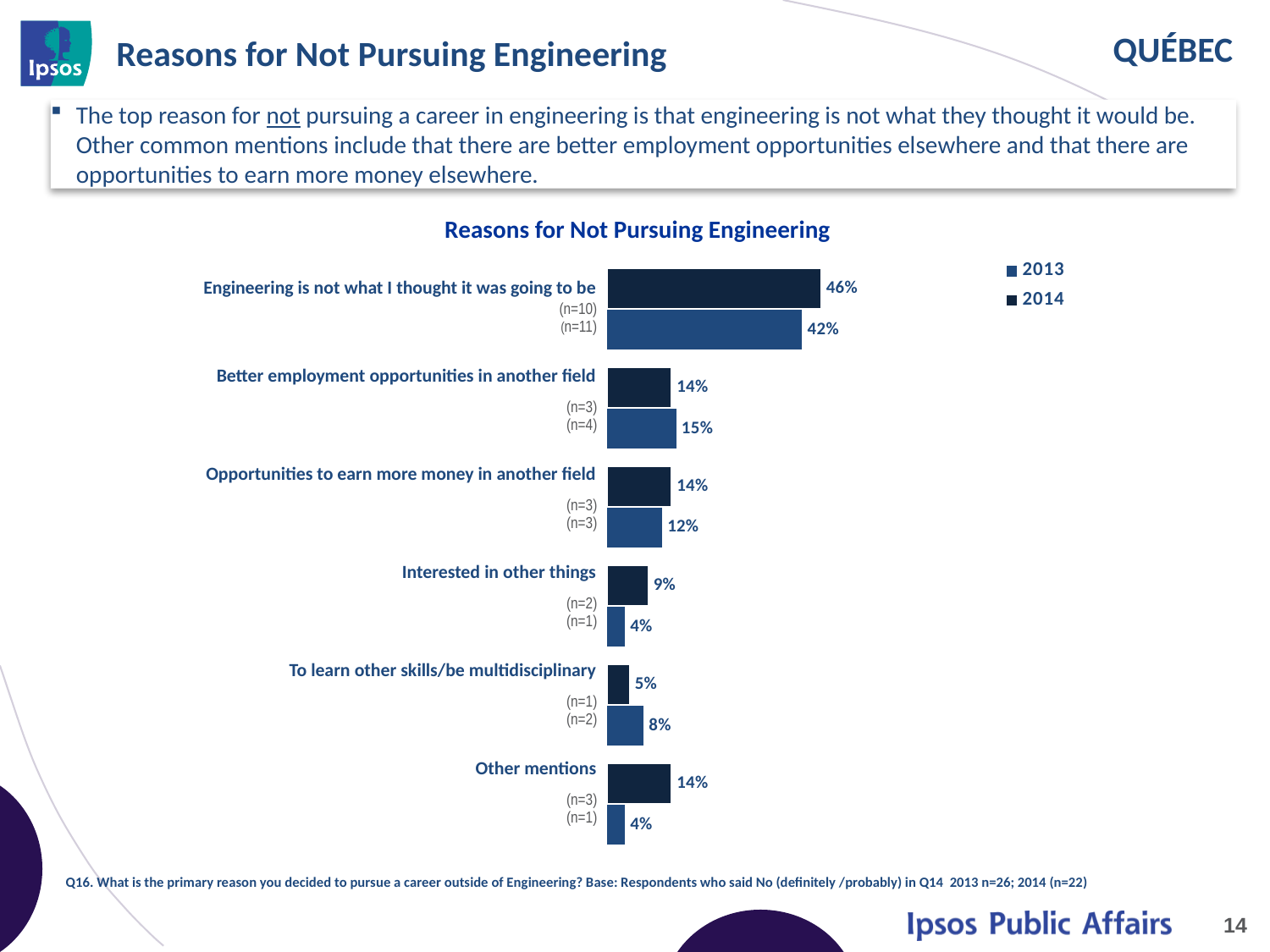
What is the 2014 value for "To learn other skills/be multidisciplinary"? 5% What is the difference between the 2013 and 2014 values for "Other mentions"? 10% What kind of chart is shown on the slide? bar chart Which category has the lowest 2013 value? Interested in other things and Other mentions (both 4%) What is the 2014 value for "Better employment opportunities in another field"? 14% What is the title of the chart? Reasons for Not Pursuing Engineering For "Interested in other things", which is larger, the 2013 value or the 2014 value? 2014 How many reason categories are plotted in the chart? 6 What is the difference between the 2013 and 2014 values for "Engineering is not what I thought it was going to be"? 4% How many series does the legend list? 2 Which category has the highest 2014 value? Engineering is not what I thought it was going to be What is the 2013 value for "Engineering is not what I thought it was going to be"? 42%